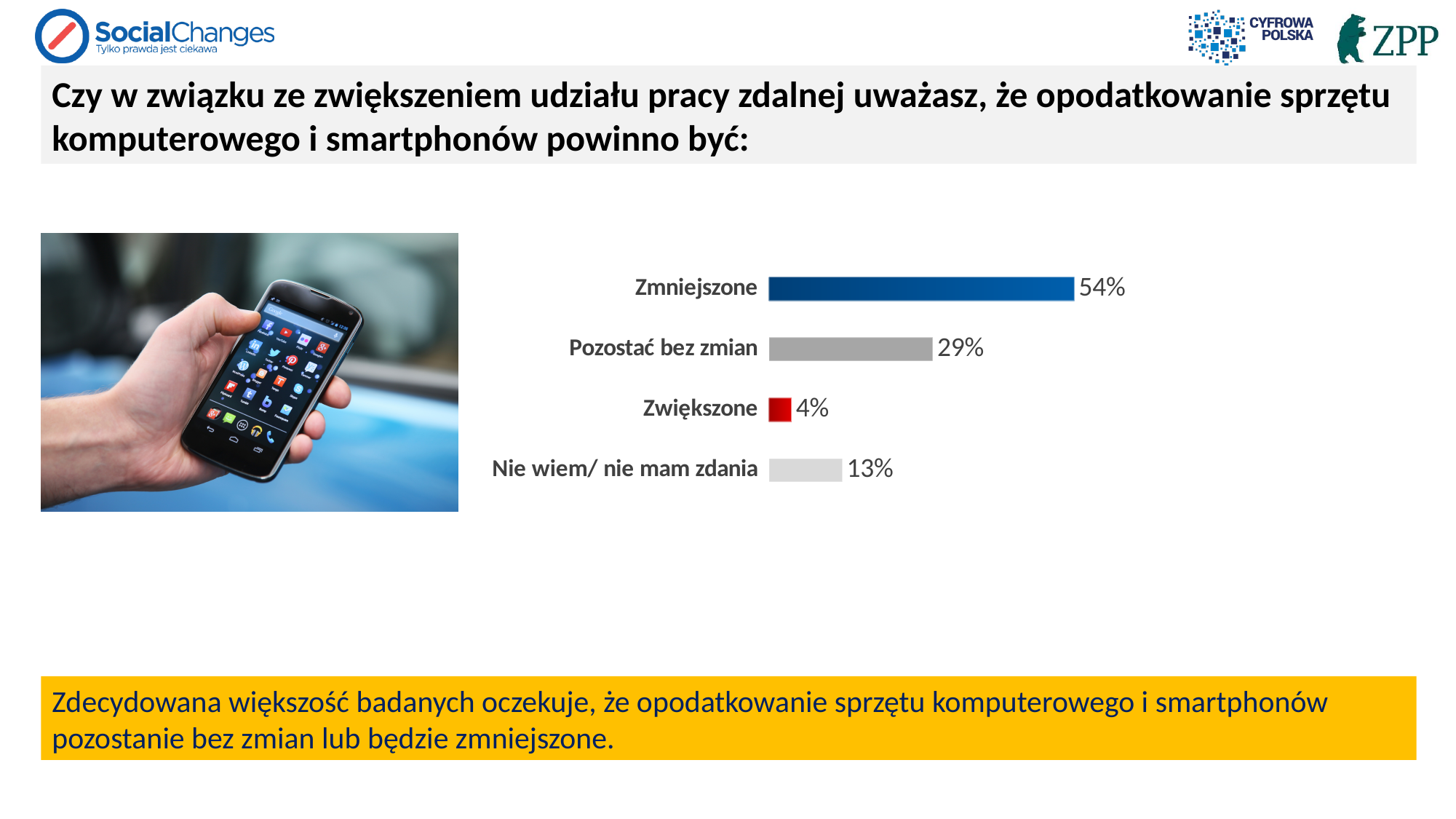
Which is larger, the value for Pozostać bez zmian or the value for Nie wiem/ nie mam zdania? Pozostać bez zmian How many categories are shown in the chart? 4 What is the difference between the values for Nie wiem/ nie mam zdania and Zwiększone? 9% What is the difference between the values for Zmniejszone and Pozostać bez zmian? 25% Which category has the highest value? Zmniejszone What is the value for Zmniejszone? 54% What is the value for Nie wiem/ nie mam zdania? 13% What is the value for Pozostać bez zmian? 29% What colour is the bar for Zwiększone? Red Which category has the lowest value? Zwiększone What is the value for Zwiększone? 4% What kind of chart is shown on the slide? Bar chart